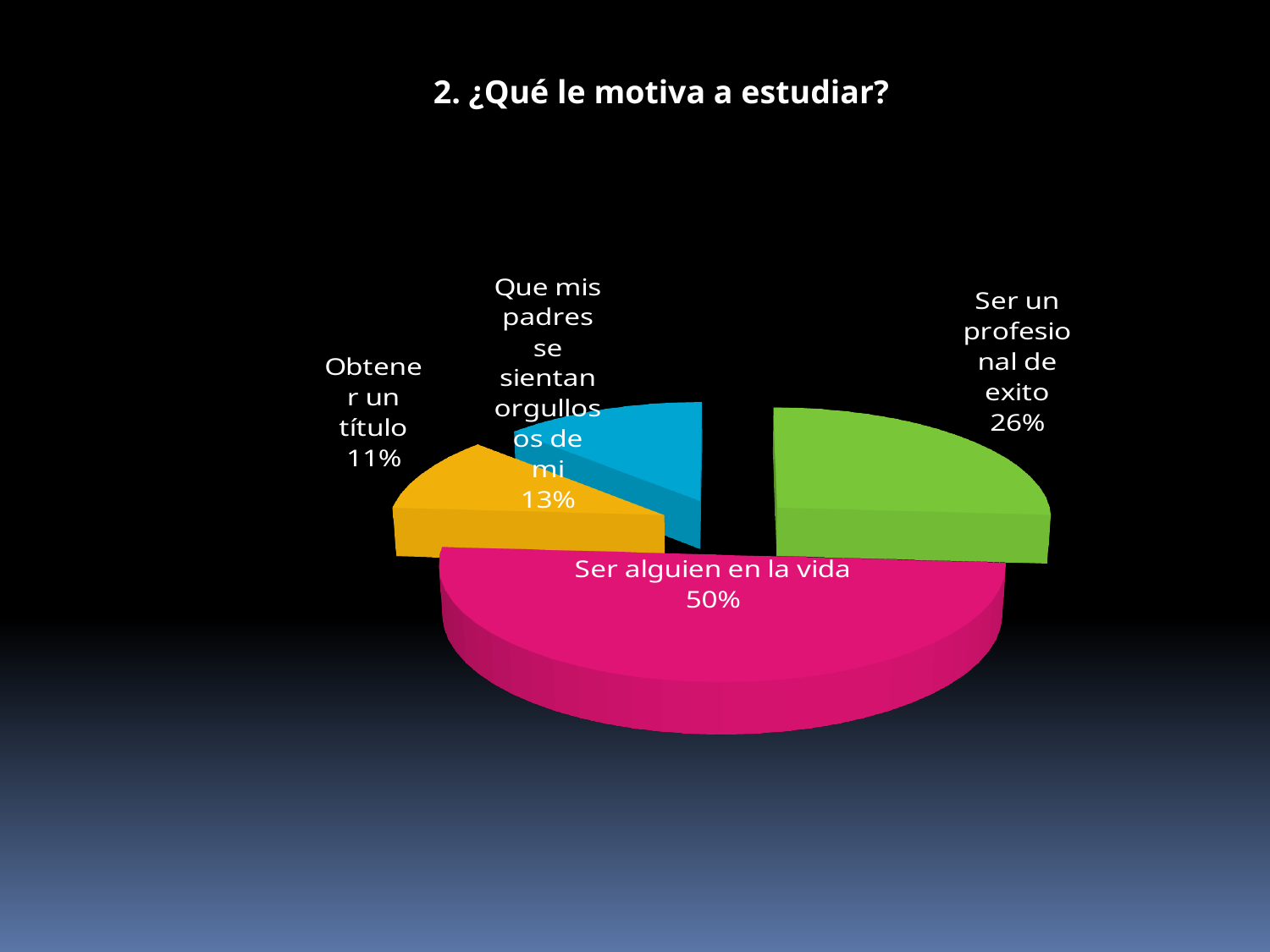
What percentage is shown for "Ser alguien en la vida"? 50% What percentage is shown for "Que mis padres se sientan orgullosos de mi"? 13% How many slices does the pie chart have? 4 Which category has the smallest share of the pie? Obtener un título What kind of chart is shown on the slide? Pie chart Which category has the largest share of the pie? Ser alguien en la vida What percentage is shown for "Obtener un título"? 11% What percentage is shown for "Ser un profesional de exito"? 26% What colour is the slice for "Ser un profesional de exito"? Green What is the difference in percentage points between "Ser alguien en la vida" and "Ser un profesional de exito"? 24 Which is larger, the share for "Que mis padres se sientan orgullosos de mi" or the share for "Obtener un título"? Que mis padres se sientan orgullosos de mi What is the title of the chart? 2. ¿Qué le motiva a estudiar?